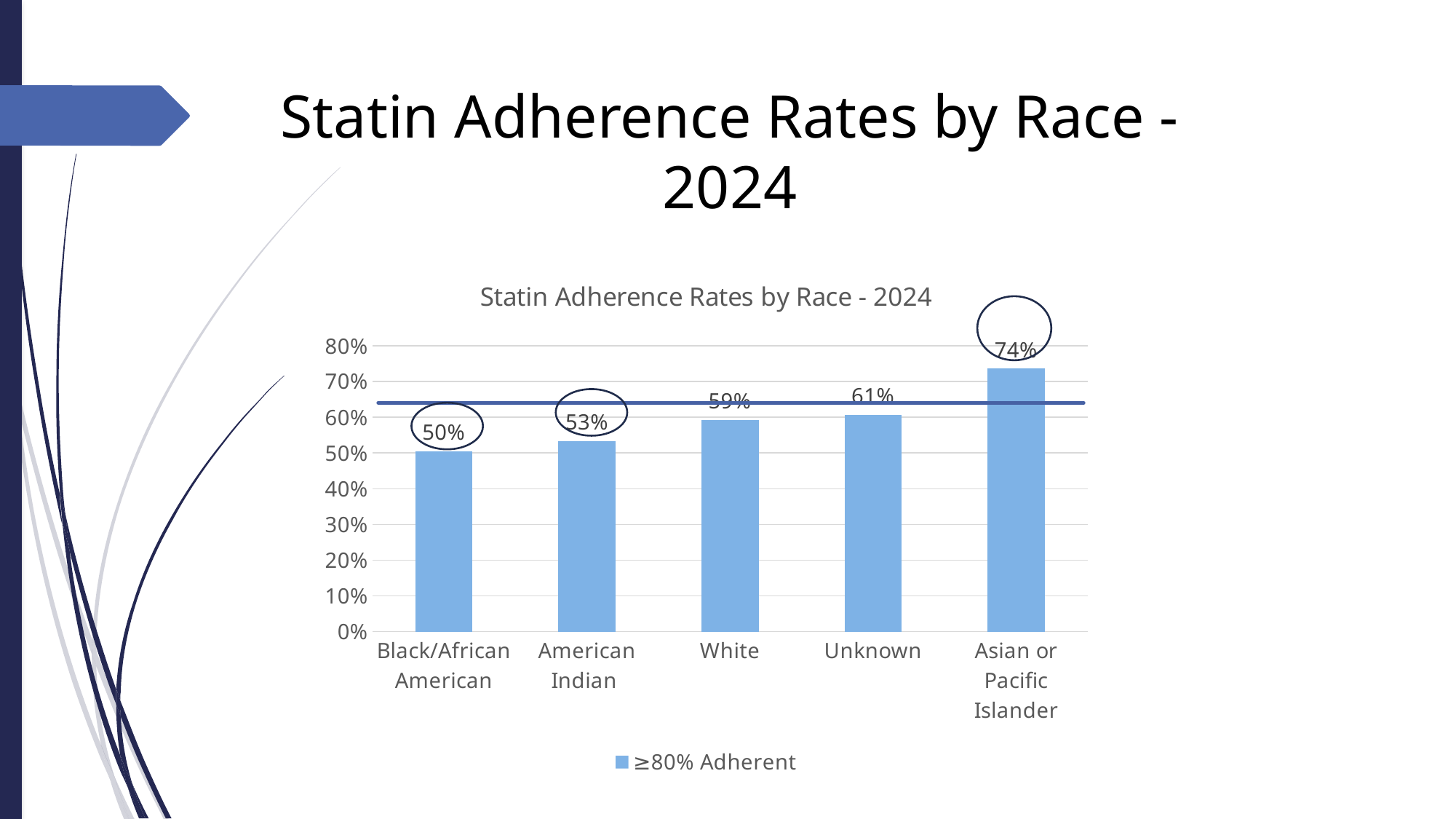
What is the statin adherence rate for Black/African American? 50% Which race category has the highest statin adherence rate? Asian or Pacific Islander What kind of chart is shown on the slide? Bar chart How many race categories are shown on the chart? 5 What is the legend entry for the series shown in the chart? ≥80% Adherent Which race category has the lowest statin adherence rate? Black/African American What is the difference between the adherence rates for Asian or Pacific Islander and Black/African American? 24% What is the statin adherence rate for White? 59% Is the value for Unknown greater or less than 70%? less Which has a higher adherence rate, Unknown or American Indian? Unknown What is the statin adherence rate for Asian or Pacific Islander? 74% How many series does the legend list? 1